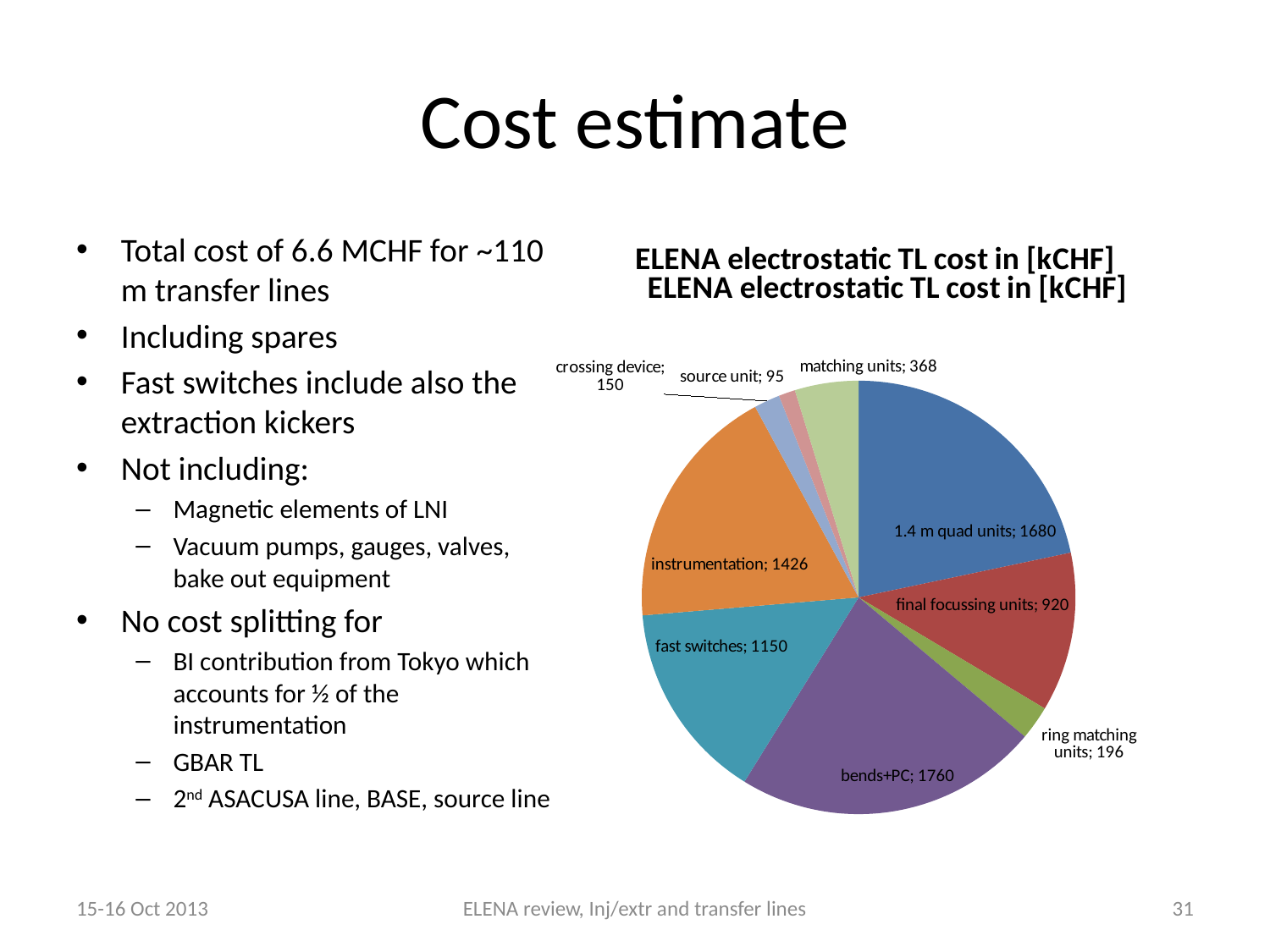
What is the difference between the bends+PC value and the 1.4 m quad units value? 80 What is the cost of the 1.4 m quad units in the pie chart? 1680 Which category has the largest slice in the pie chart? bends+PC Which category has the smallest slice in the pie chart? source unit Which is larger, final focussing units or matching units? final focussing units What is the value shown for fast switches? 1150 What is the value shown for the crossing device? 150 What is the difference between the ring matching units value and the crossing device value? 46 How many categories are shown in the pie chart? 9 What is the value shown for instrumentation? 1426 What type of chart is shown on the slide? pie chart What is the title of the chart? ELENA electrostatic TL cost in [kCHF]